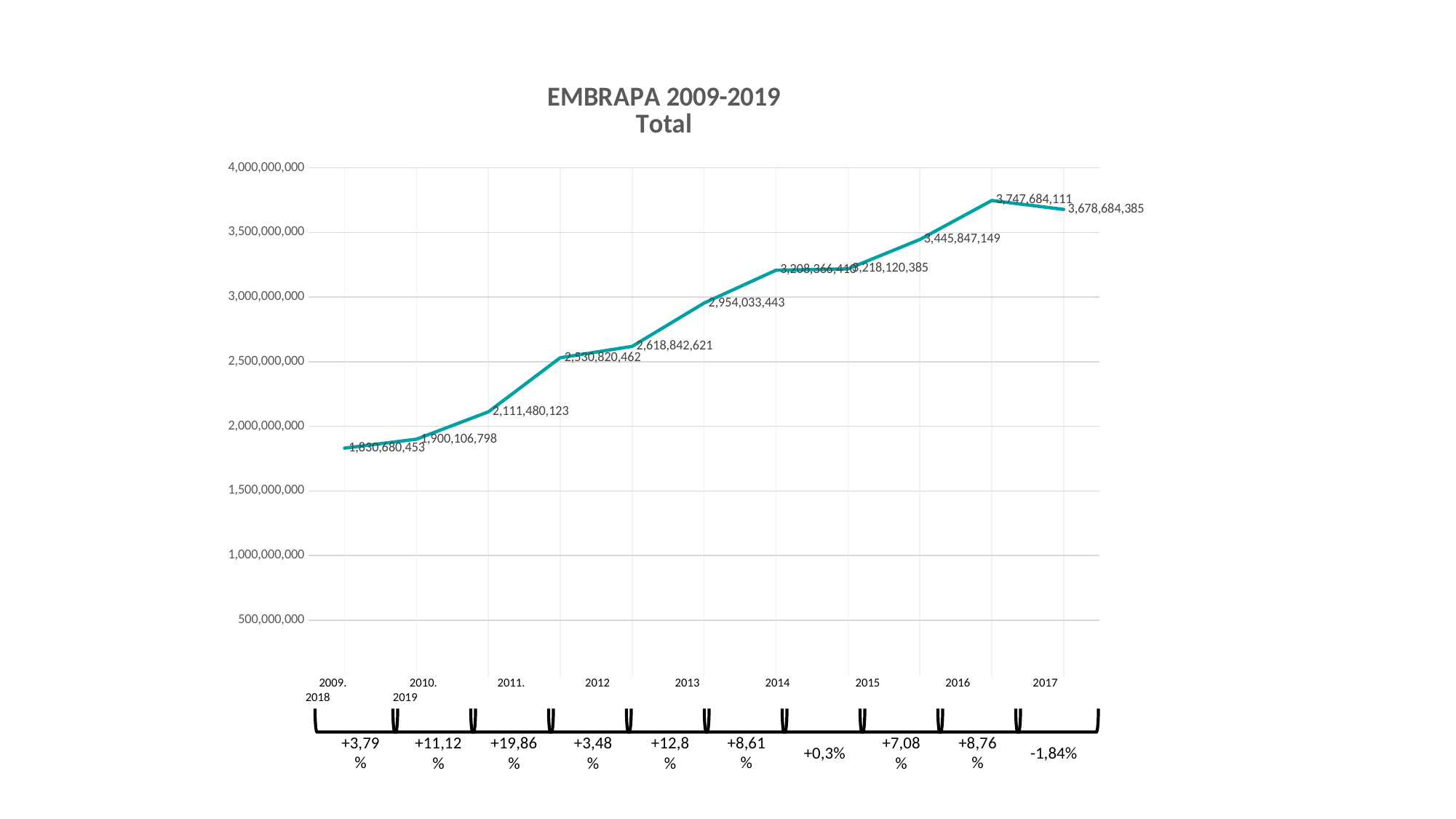
What is the title of the chart? EMBRAPA 2009-2019 Total What kind of chart is shown on the slide? line chart Which percentage change shown below the chart is the only negative one? -1,84% What is the difference between the highest point (3,747,684,111) and the last point (3,678,684,385)? 68,999,726 Is the value of the first point greater or less than 2,000,000,000? less Do the values generally rise or fall from left to right along the x axis? rise What is the value of the last (rightmost) point on the line? 3,678,684,385 How many data points are plotted on the line? 11 What is the value of the first (leftmost) point on the line? 1,830,680,453 What is the highest value plotted on the line? 3,747,684,111 What is the lowest value plotted on the line? 1,830,680,453 Is the value of the last point greater or less than 3,500,000,000? greater